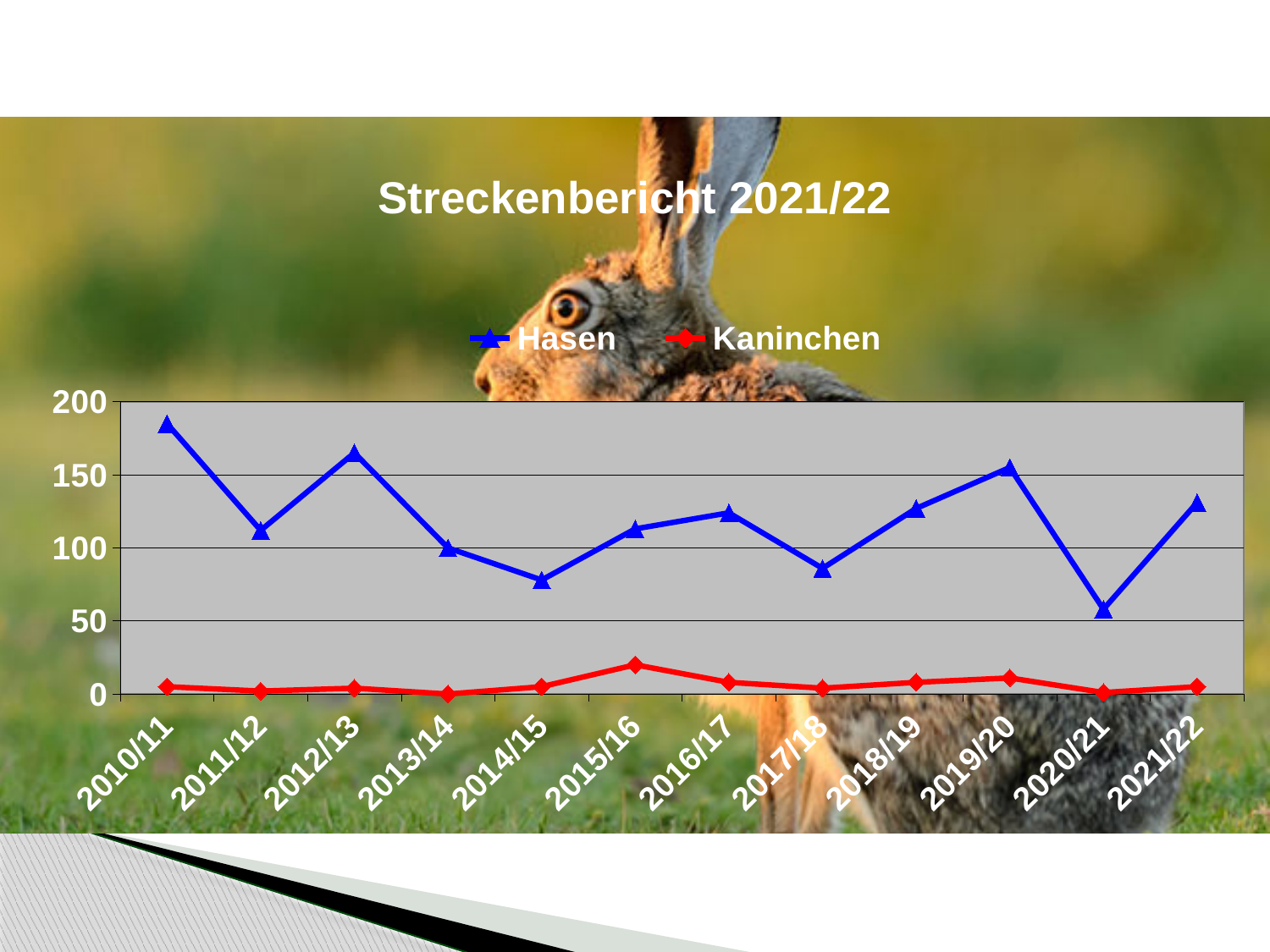
What is the title of the chart? Streckenbericht 2021/22 In which season is the Hasen value highest? 2010/11 Is the Hasen value for 2020/21 greater or less than 100? less Is the Kaninchen value for 2015/16 greater or less than 50? less In which season is the Hasen value lowest? 2020/21 How many series does the legend list? 2 Which season has the larger Hasen value, 2011/12 or 2012/13? 2012/13 How many seasons are plotted along the x axis? 12 Is the Hasen value for 2010/11 greater or less than 150? greater What kind of chart is shown on the slide? line chart In which season is the Kaninchen value highest? 2015/16